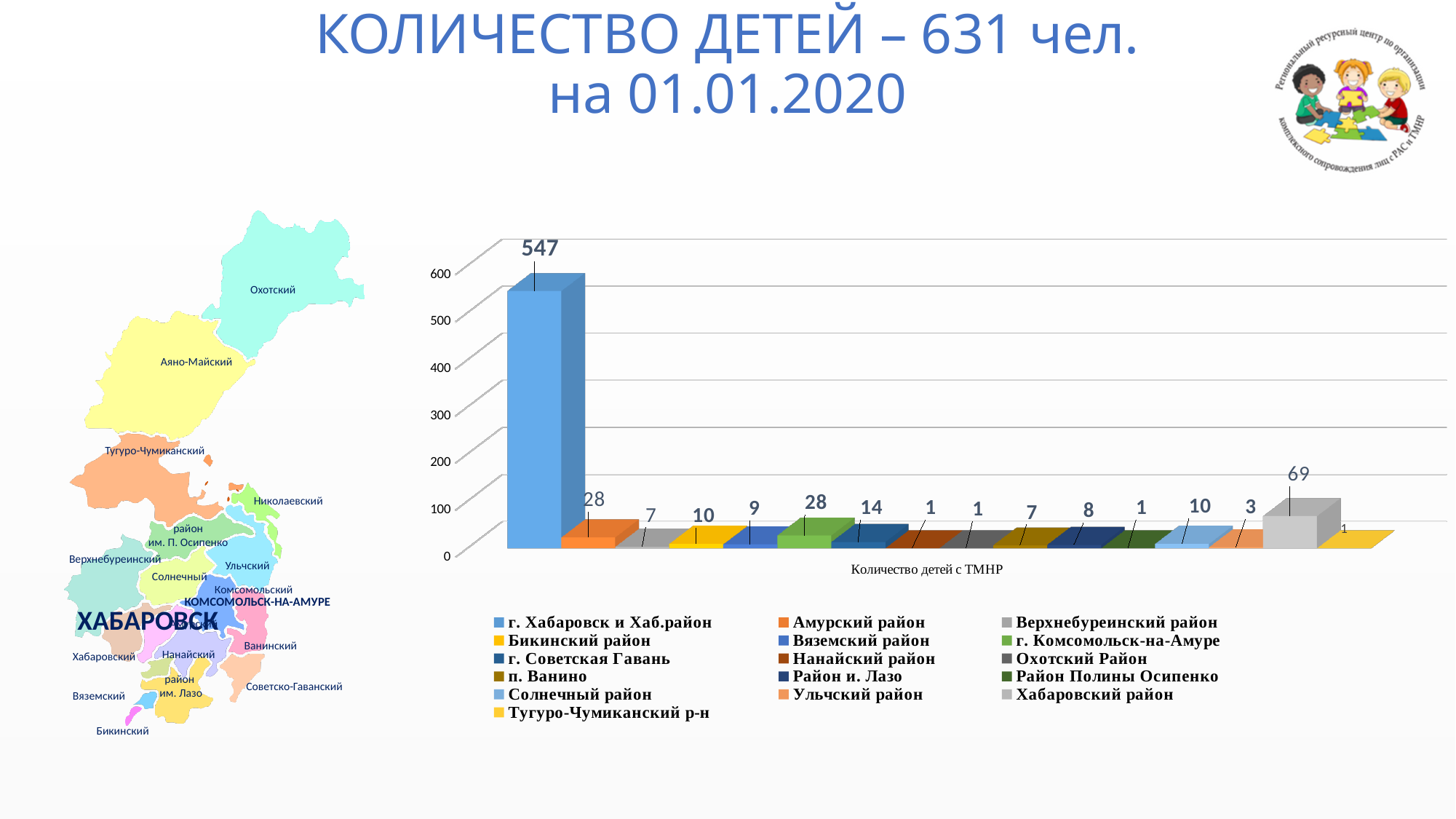
What is the difference between the values for Хабаровский район and Амурский район? 41 What is the value for г. Советская Гавань? 14 Which is larger, the value for Амурский район or the value for Верхнебуреинский район? Амурский район How many series does the chart legend list? 16 What is the difference between the values for г. Хабаровск и Хаб.район and Хабаровский район? 478 What is the value for Хабаровский район? 69 What is the value for Ульчский район? 3 What is the value for г. Хабаровск и Хаб.район? 547 What total number of children is stated in the slide title? 631 чел. What is the category label shown on the x axis? Количество детей с ТМНР What type of chart is shown on the slide? bar chart Which series has the highest value? г. Хабаровск и Хаб.район